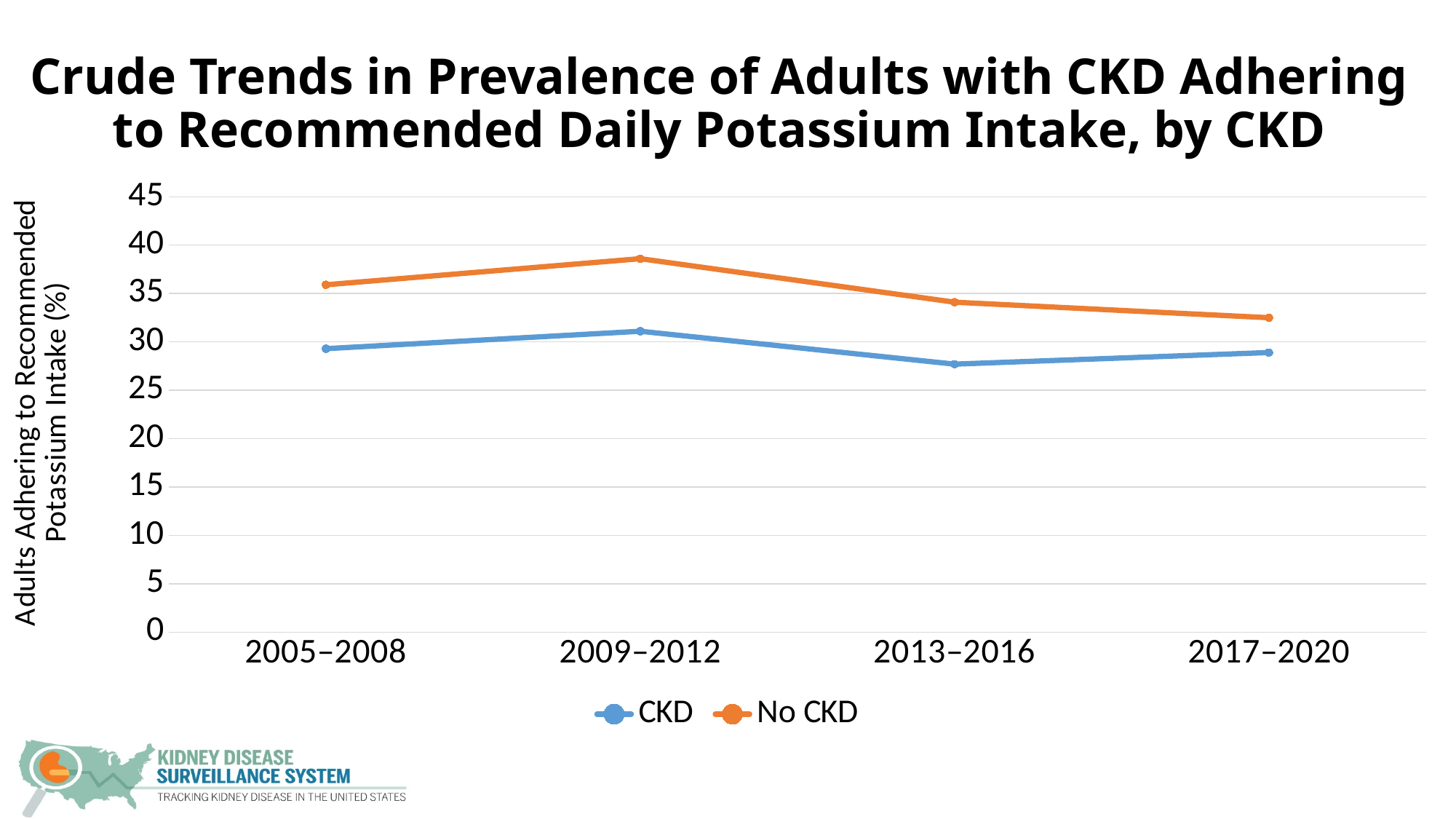
Is the value for No CKD in 2009–2012 greater or less than 35? greater Is the value for CKD in 2013–2016 greater or less than 30? less In which period is the CKD series at its lowest? 2013–2016 Does the No CKD series rise or fall from 2009–2012 to 2017–2020? fall What kind of chart is shown on the slide? Line chart In which period is the No CKD series at its highest? 2009–2012 Is the value for CKD in 2009–2012 greater or less than 30? greater How many time periods are plotted along the x axis? 4 In which period is the No CKD series at its lowest? 2017–2020 In 2017–2020, which series has the larger value, CKD or No CKD? No CKD In which period is the CKD series at its highest? 2009–2012 How many series does the legend list? 2